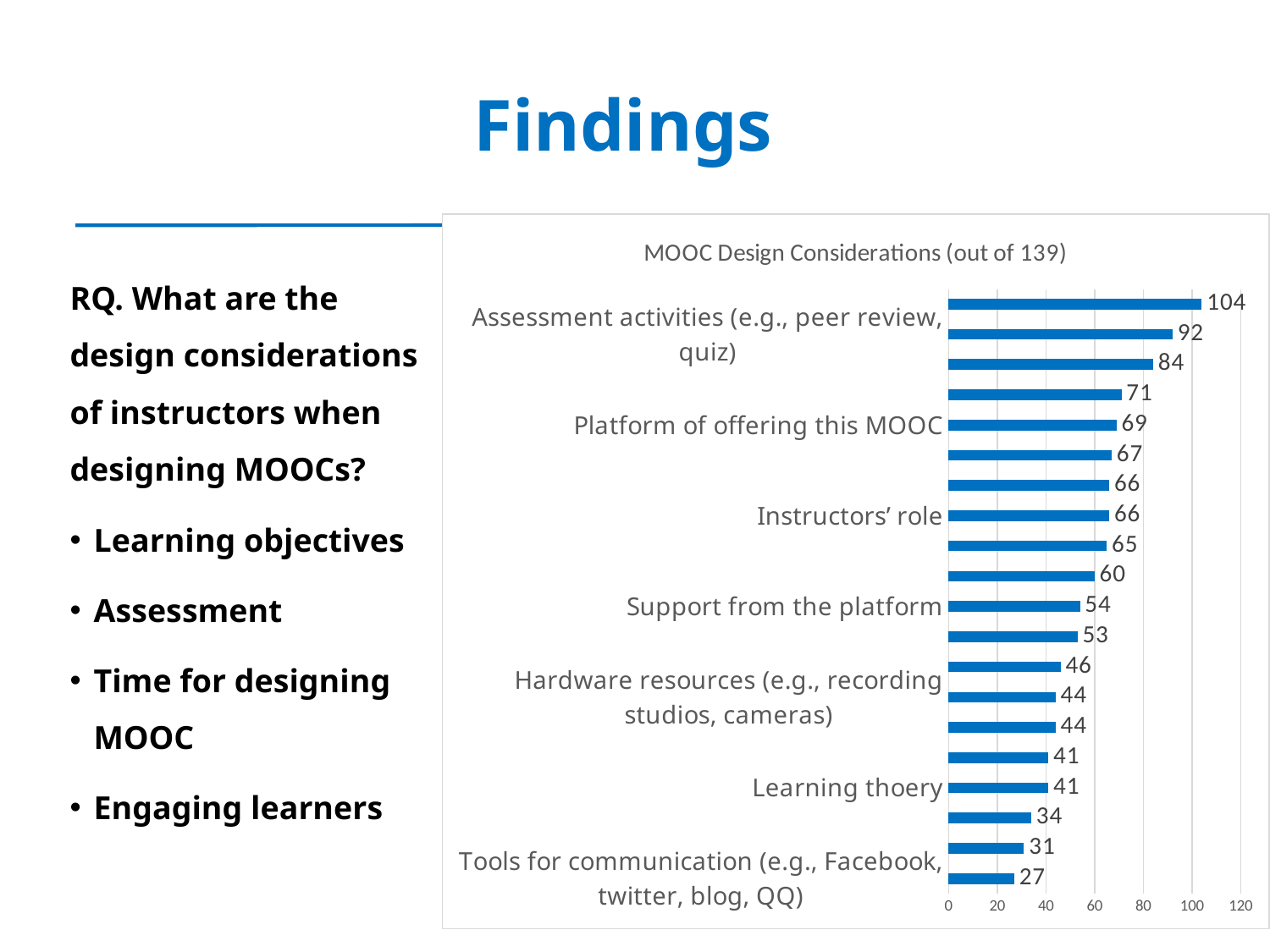
What is the value for Platform of offering this MOOC? 69 What is the value for Support from the platform? 54 What is the title of the chart? MOOC Design Considerations (out of 139) What is the highest value shown in the chart? 104 How many bars are plotted in the chart? 20 What is the value for Learning thoery? 41 What is the value for Tools for communication (e.g., Facebook, twitter, blog, QQ)? 27 What is the lowest value shown in the chart? 27 Which is larger, the value for Platform of offering this MOOC or the value for Learning thoery? Platform of offering this MOOC What is the value for Instructors' role? 66 What kind of chart is shown on the slide? bar chart What is the difference between the highest value (104) and the lowest value (27) in the chart? 77